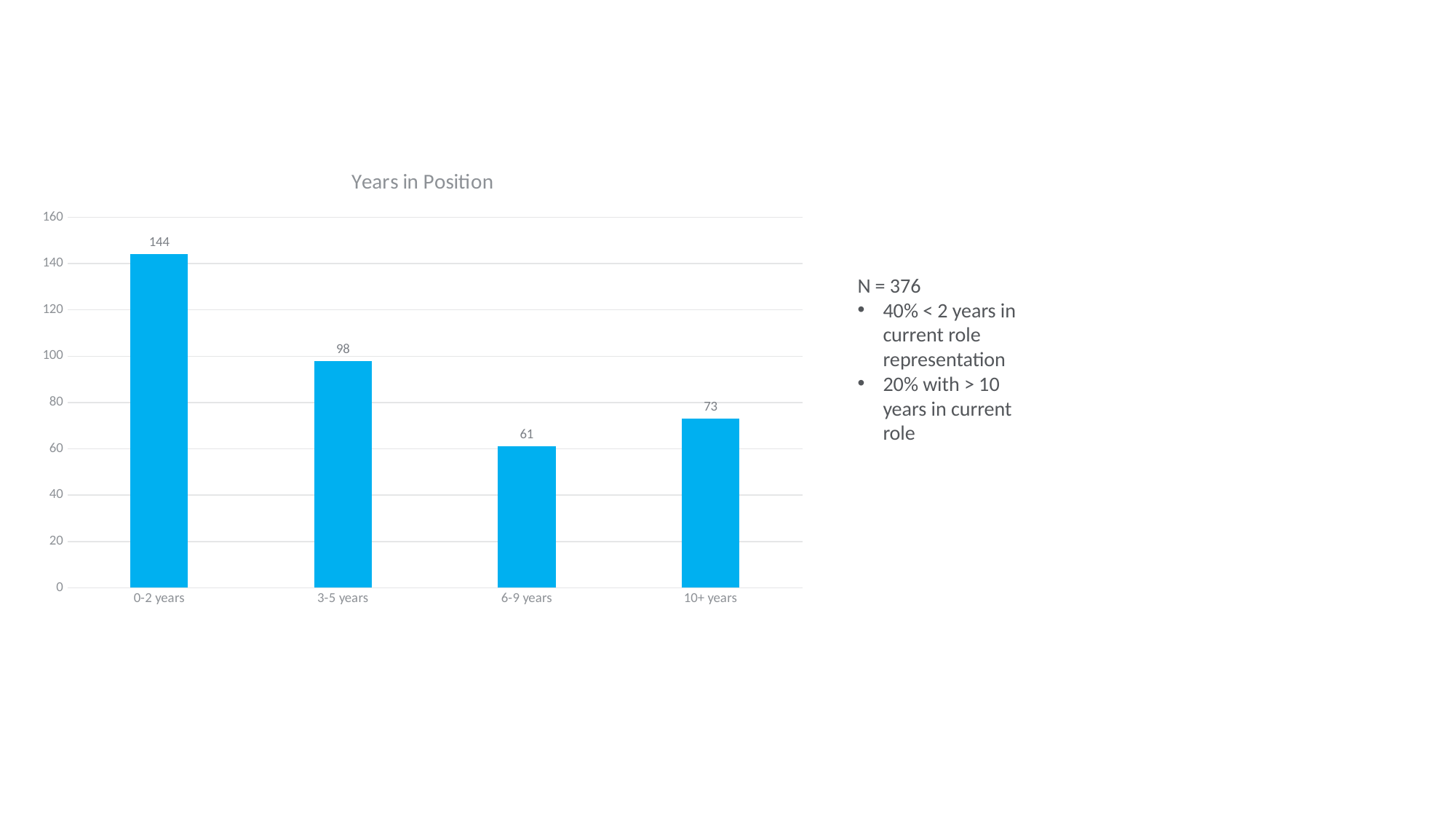
What is the difference between the values for 0-2 years and 3-5 years? 46 What is the value for 0-2 years? 144 What is the value for 10+ years? 73 What is the value for 6-9 years? 61 What is the value for 3-5 years? 98 What is the title of the chart? Years in Position How many categories are shown on the x axis? 4 Which category has the highest value? 0-2 years Which category has the lowest value? 6-9 years What kind of chart is shown? bar chart Is the value for 3-5 years greater or less than 100? less Which is larger, the value for 10+ years or the value for 6-9 years? 10+ years